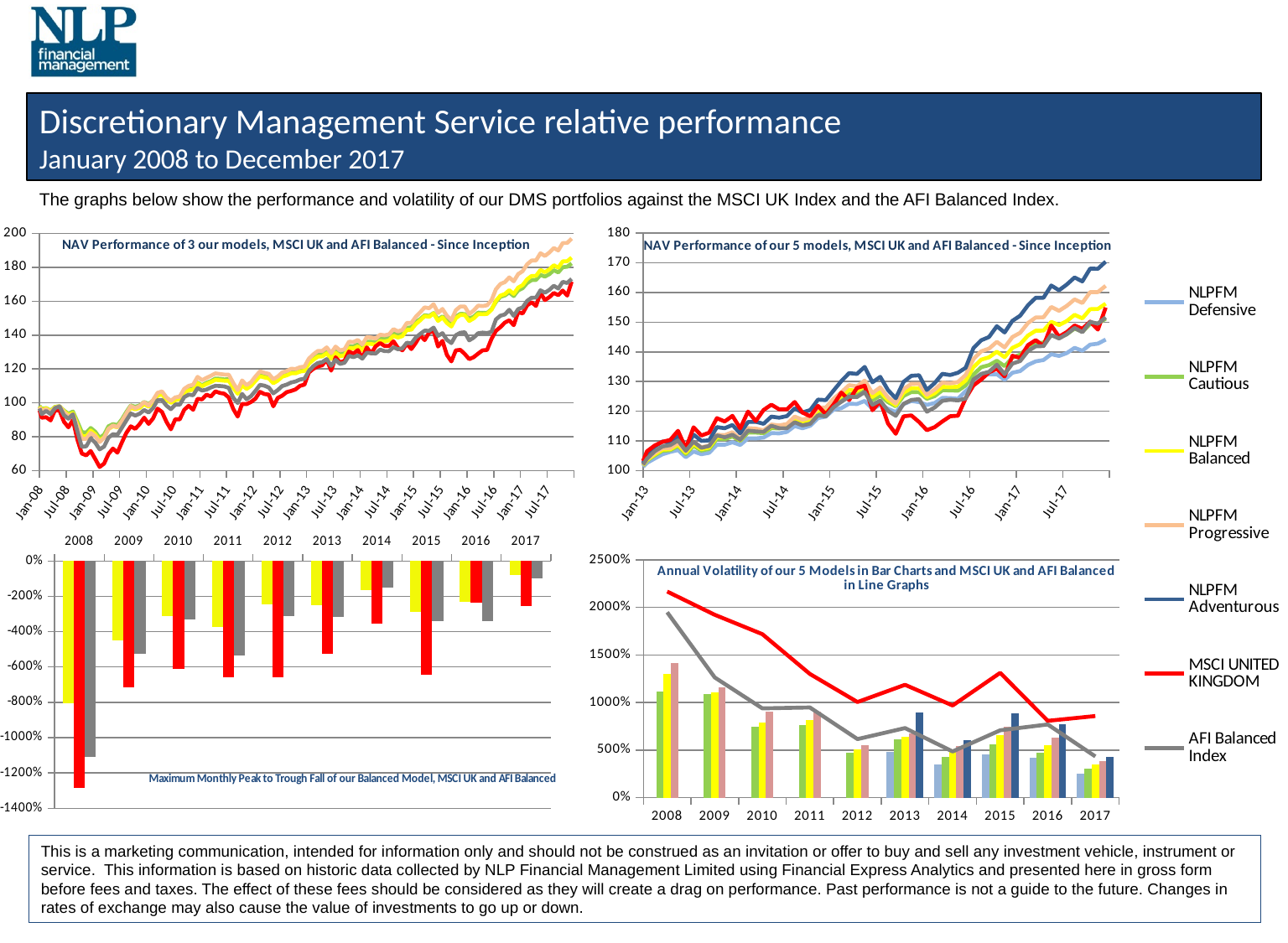
In the bottom-right 'Annual Volatility' chart, is the MSCI UNITED KINGDOM value for 2017 greater or less than 1000%? less In the top-right 'NAV Performance of our 5 models' chart, which series ends lowest at the end of 2017? NLPFM Defensive In the top-left 'NAV Performance of 3 our models' chart, is the lowest point of the MSCI UNITED KINGDOM line around early 2009 greater or less than 80? less In the bottom-right 'Annual Volatility' chart, does the MSCI UNITED KINGDOM line rise or fall overall from 2008 to 2017? Falls In the top-right 'NAV Performance of our 5 models' chart, which series ends highest at the end of 2017? NLPFM Adventurous In the top-right 'NAV Performance of our 5 models' chart, does the NLPFM Adventurous line rise or fall from Jan-13 to the end of 2017? Rises How many series does the legend on the right side of the slide list? 7 In the bottom-right 'Annual Volatility' chart, how many years are shown on the x axis? 10 In the bottom-left 'Maximum Monthly Peak to Trough Fall' chart, which had the larger fall in 2008: MSCI UNITED KINGDOM or NLPFM Balanced? MSCI UNITED KINGDOM In the bottom-right 'Annual Volatility' chart, is the MSCI UNITED KINGDOM value for 2008 greater or less than 2000%? greater What kind of chart is the bottom-left chart titled 'Maximum Monthly Peak to Trough Fall of our Balanced Model, MSCI UK and AFI Balanced'? Bar chart What kind of chart is the top-left chart titled 'NAV Performance of 3 our models, MSCI UK and AFI Balanced - Since Inception'? Line chart